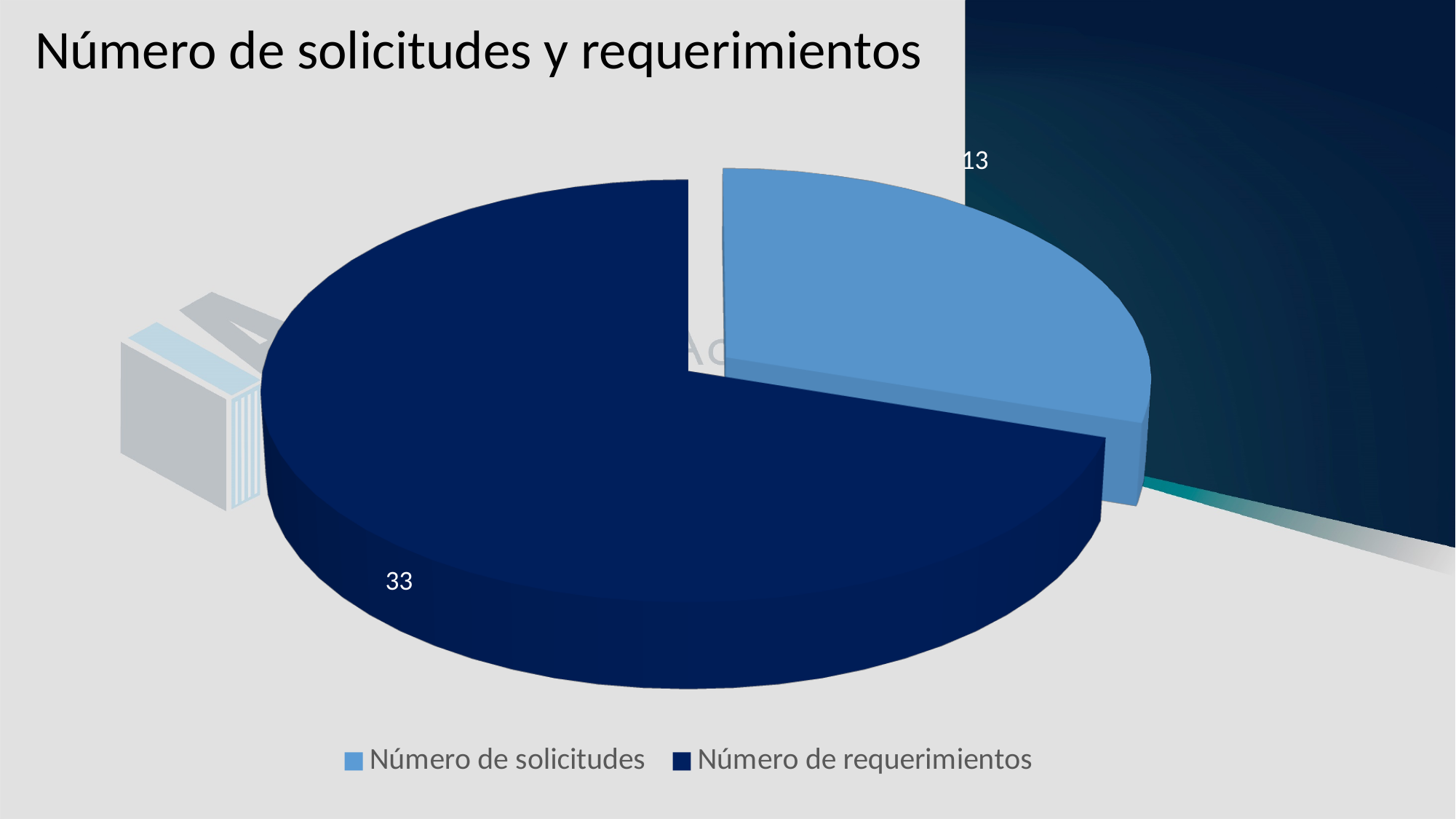
What is the title of the chart? Número de solicitudes y requerimientos Which is larger, Número de solicitudes or Número de requerimientos? Número de requerimientos Which slice is the smallest? Número de solicitudes Which slice is the largest? Número de requerimientos What colour is the Número de solicitudes slice? light blue What is the total of the two slices in the pie chart? 46 How many entries does the legend list? 2 What is the difference between Número de requerimientos and Número de solicitudes? 20 What is the value for Número de requerimientos? 33 How many slices does the pie chart have? 2 What is the value for Número de solicitudes? 13 What type of chart is shown on the slide? pie chart